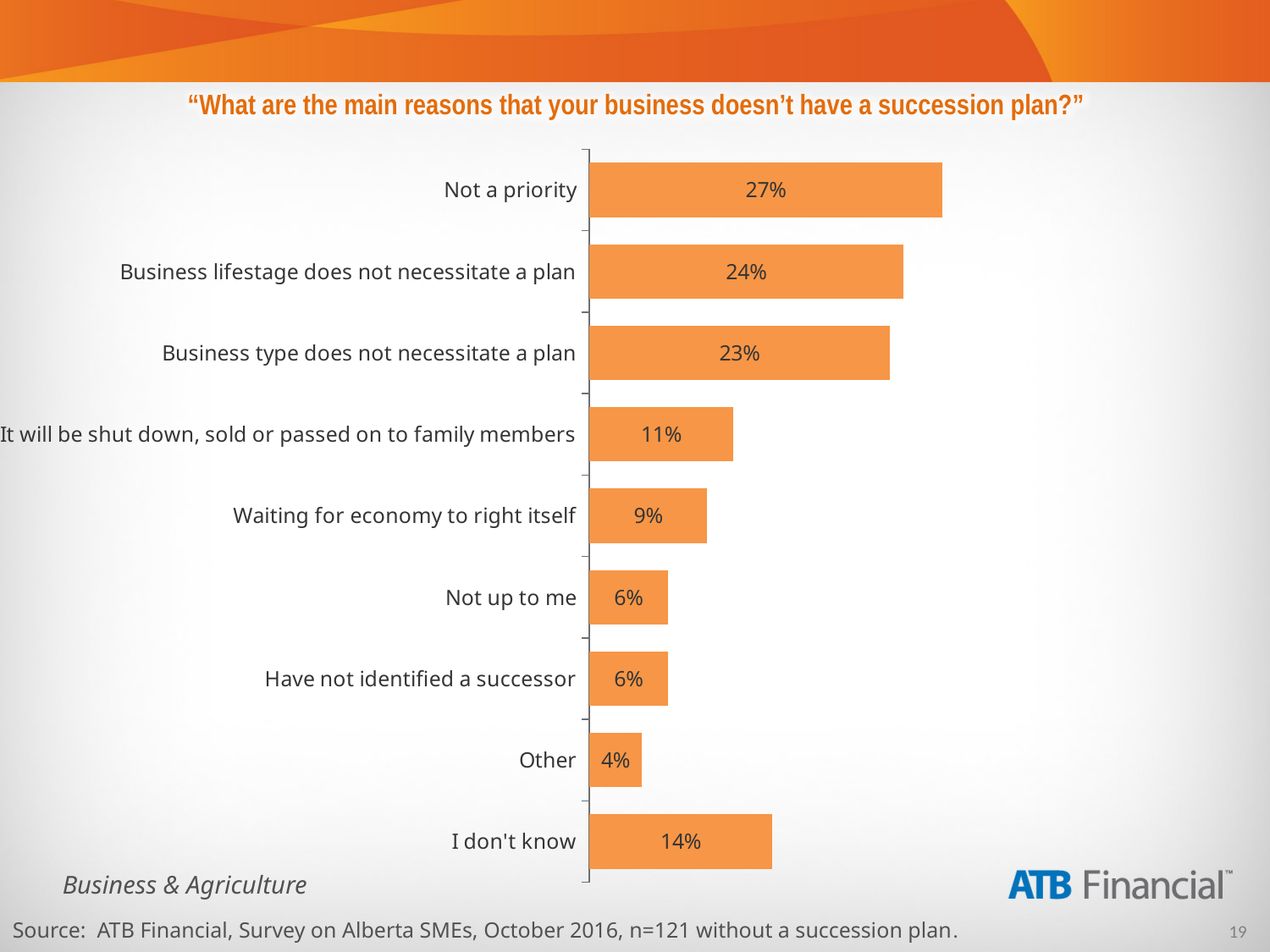
What is the difference between "Not a priority" and "Business lifestage does not necessitate a plan"? 3% Which category has the lowest percentage? Other Which is larger: "It will be shut down, sold or passed on to family members" or "I don't know"? I don't know What is the title of the chart? "What are the main reasons that your business doesn't have a succession plan?" Which is larger: "Business type does not necessitate a plan" or "Waiting for economy to right itself"? Business type does not necessitate a plan What percentage answered "I don't know"? 14% What kind of chart is shown on the slide? Bar chart Which reason has the highest percentage? Not a priority What is the difference between "I don't know" and "Other"? 10% How many categories are shown in the chart? 9 What percentage of respondents said "Not a priority"? 27% What is the value for "Waiting for economy to right itself"? 9%